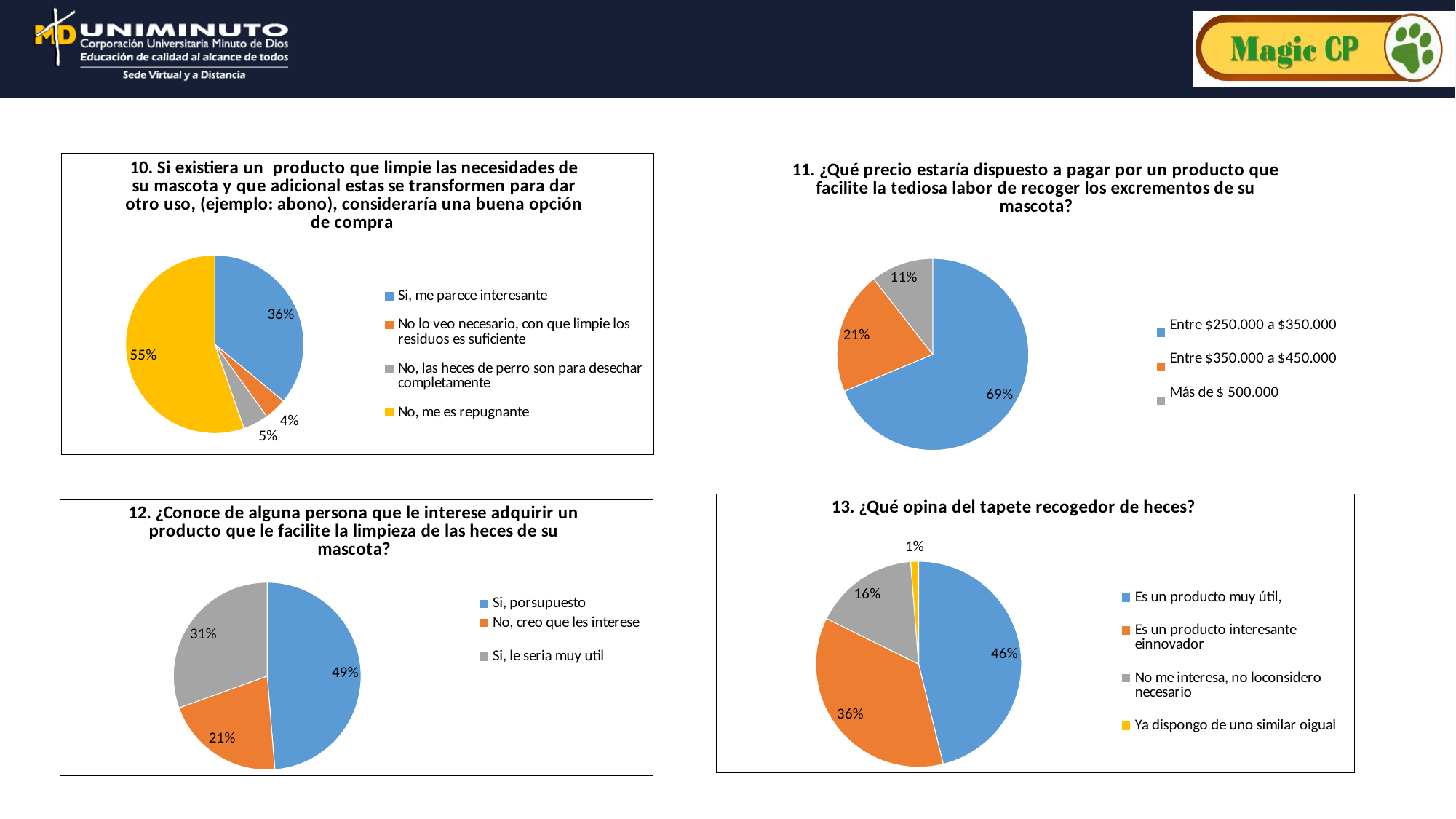
In the top-left chart (question 10), how many slices does the pie have? 4 In the bottom-right chart (question 13), which response has the smallest share? Ya dispongo de uno similar o igual In the top-right chart (question 11), what is the difference between the shares for "Entre $350.000 a $450.000" and "Más de $ 500.000"? 10% In the top-left chart (question 10), what share of respondents answered "No, me es repugnante"? 55% What type of chart is used for question 13 in the bottom-right? Pie chart In the bottom-right chart (question 13), what share answered "Es un producto interesante e innovador"? 36% In the bottom-left chart (question 12), which is larger: "Si, porsupuesto" or "No, creo que les interese"? Si, porsupuesto In the bottom-left chart (question 12), how many entries does the legend list? 3 In the top-right chart (question 11), which price range has the largest share? Entre $250.000 a $350.000 In the top-left chart (question 10), which response has the smallest share? No lo veo necesario, con que limpie los residuos es suficiente In the top-right chart (question 11), what share chose "Entre $250.000 a $350.000"? 69% In the bottom-left chart (question 12), what share answered "Si, le seria muy util"? 31%